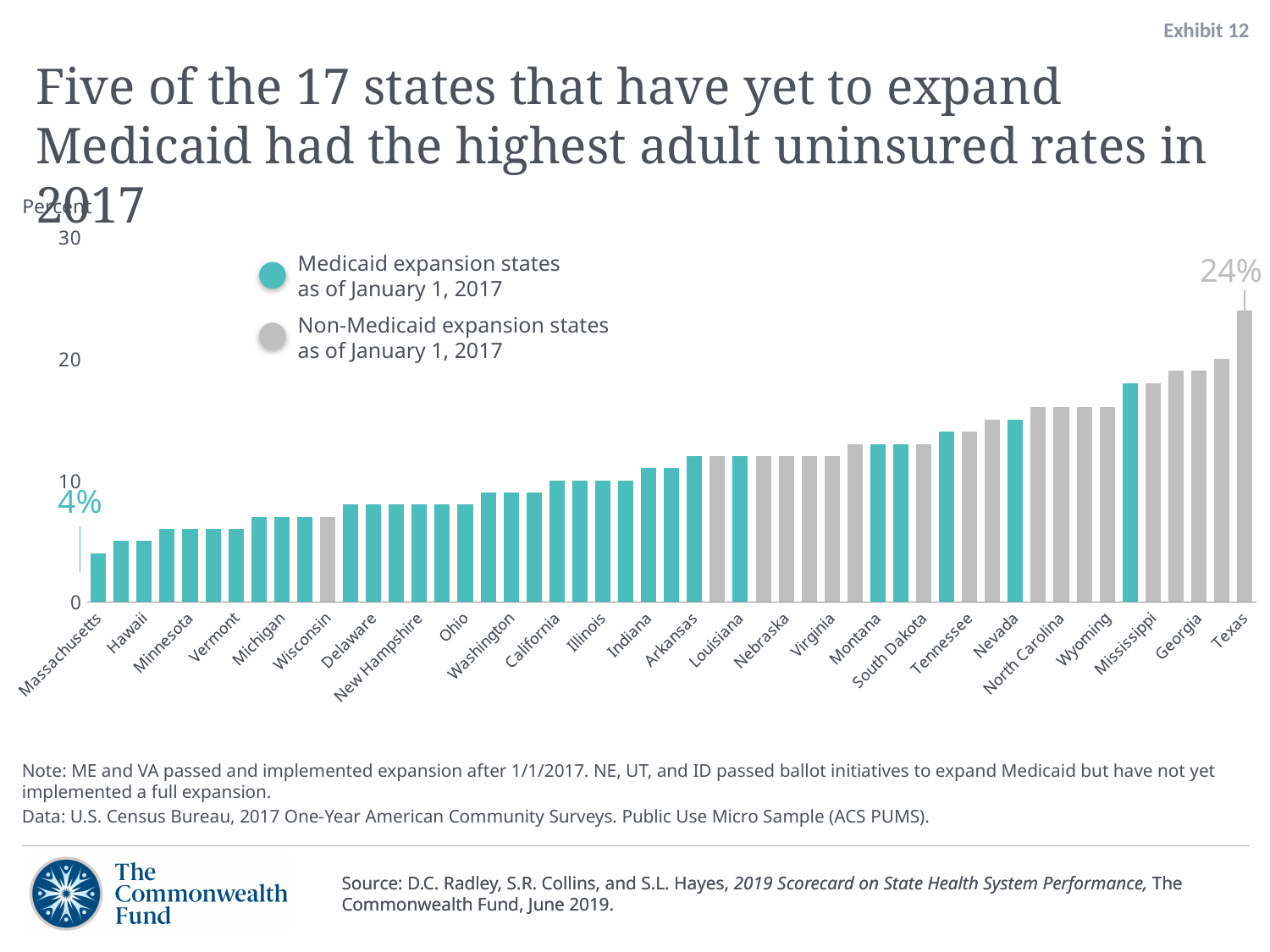
What is the difference between the uninsured rates of Texas and Massachusetts? 20 percentage points Which state has a higher uninsured rate, Georgia or Hawaii? Georgia What kind of chart is shown on the slide? Bar chart Which state has the highest adult uninsured rate in the chart? Texas Is the value for Georgia greater or less than 10? greater Which state has the lowest adult uninsured rate in the chart? Massachusetts What is the adult uninsured rate shown for Massachusetts? 4% Is the value for Hawaii greater or less than 10? less Do the uninsured rates rise or fall moving from left to right along the x axis? Rise How many series does the legend list? 2 What is the adult uninsured rate shown for Texas? 24% Is the value for Texas greater or less than 20? greater